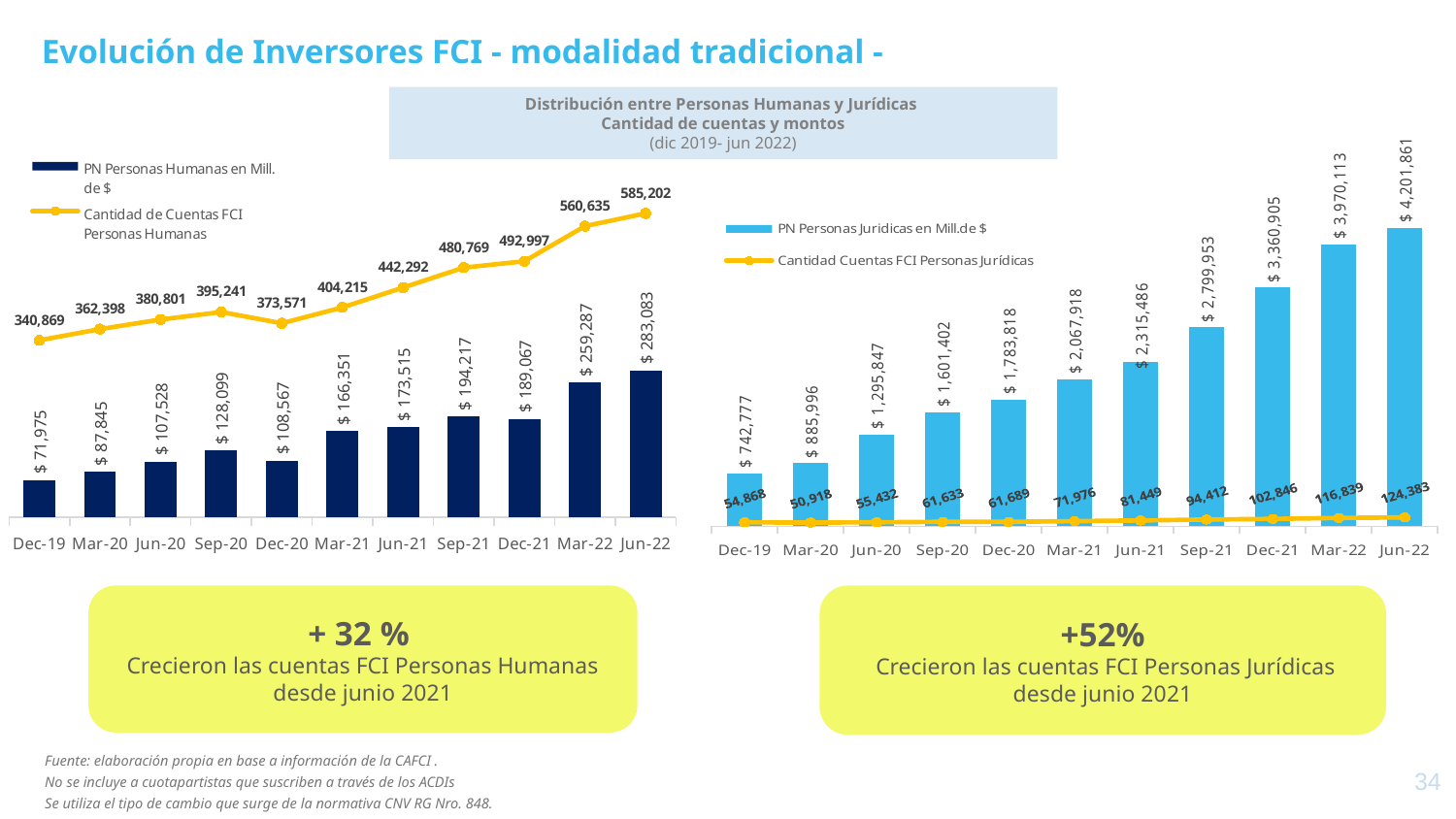
How many periods are shown on the x axis of the left chart (Personas Humanas)? 11 In the right chart (Personas Jurídicas), which is larger: the Cantidad Cuentas for Dec-19 or for Mar-20? Dec-19 In the left chart (Personas Humanas), what is the Cantidad de Cuentas FCI Personas Humanas for Dec-19? 340,869 In the left chart (Personas Humanas), what is the value of PN Personas Humanas en Mill. de $ for Jun-22? $ 283,083 In the left chart (Personas Humanas), what is the difference in Cantidad de Cuentas FCI Personas Humanas between Jun-22 and Mar-22? 24,567 What kind of chart is the right chart (Personas Jurídicas)? Combined bar and line chart How many series does the legend of the right chart (Personas Jurídicas) list? 2 In the right chart (Personas Jurídicas), what is the value of PN Personas Jurídicas en Mill. de $ for Mar-22? $ 3,970,113 In the right chart (Personas Jurídicas), which period has the highest PN Personas Jurídicas bar? Jun-22 In the right chart (Personas Jurídicas), what is the Cantidad Cuentas FCI Personas Jurídicas for Jun-22? 124,383 In the right chart (Personas Jurídicas), do the PN Personas Jurídicas bars rise or fall from Dec-19 to Jun-22? Rise In the left chart (Personas Humanas), which period has the lowest PN Personas Humanas bar? Dec-19